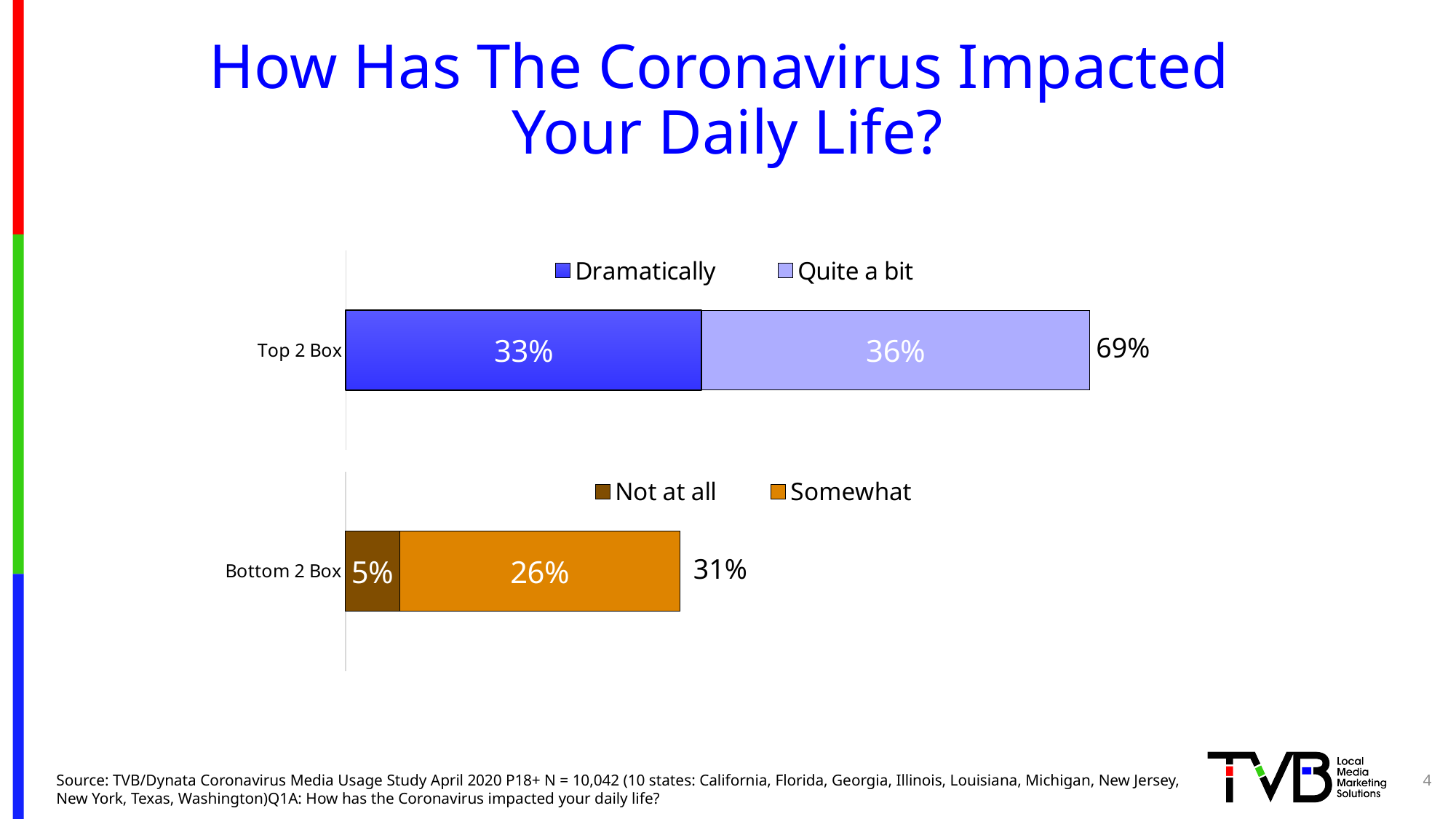
In the upper chart (Top 2 Box), what percentage is shown for Quite a bit? 36% In the lower chart, which segment is smaller, Not at all or Somewhat? Not at all In the lower chart (Bottom 2 Box), what percentage is shown for Somewhat? 26% In the lower chart (Bottom 2 Box), what percentage is shown for Not at all? 5% In the lower chart, what is the total of the Bottom 2 Box stacked bar? 31% What type of chart is the upper chart (Top 2 Box)? Stacked bar chart What is the difference between the Top 2 Box total in the upper chart and the Bottom 2 Box total in the lower chart? 38% In the upper chart (Top 2 Box), what percentage is shown for Dramatically? 33% In the upper chart, what is the total of the Top 2 Box stacked bar? 69% In the upper chart, which segment is larger, Dramatically or Quite a bit? Quite a bit In the lower chart, what is the difference between the Somewhat and Not at all percentages? 21% How many series does the legend of the upper chart list? 2